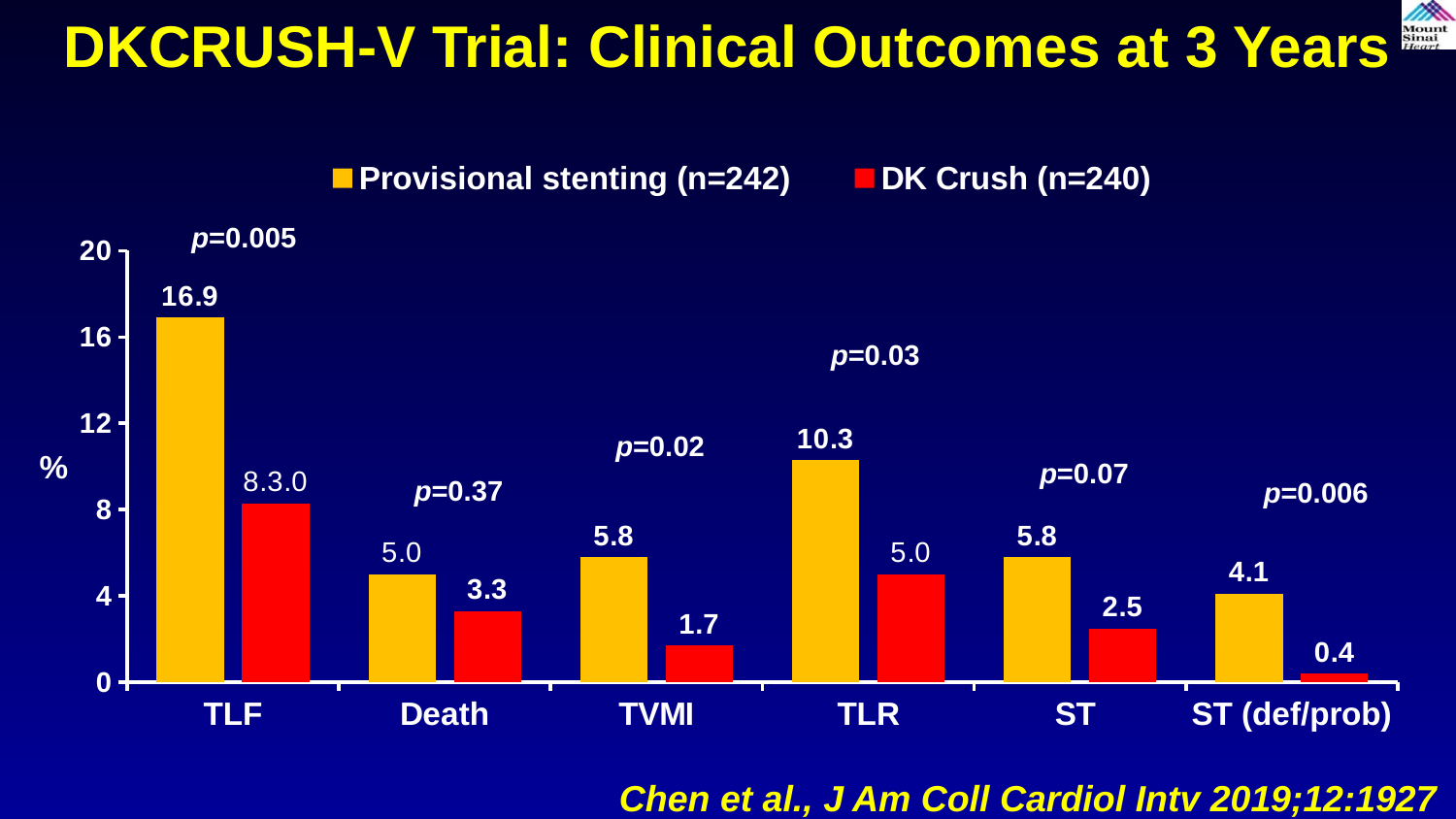
What is the value for DK Crush for ST (def/prob)? 0.4 What is the difference between Provisional stenting and DK Crush for TVMI? 4.1 What is the value for DK Crush for TLR? 5.0 Is the value for Provisional stenting for TLR greater or less than 8? greater What type of chart is shown on the slide? bar chart What is the value for Provisional stenting for TLF? 16.9 Which category has the lowest value for DK Crush? ST (def/prob) What p-value is shown above the TLF bars? p=0.005 Which is larger for Death: Provisional stenting or DK Crush? Provisional stenting Which category has the highest value for Provisional stenting? TLF How many series does the legend list? 2 How many outcome categories are shown on the x axis? 6